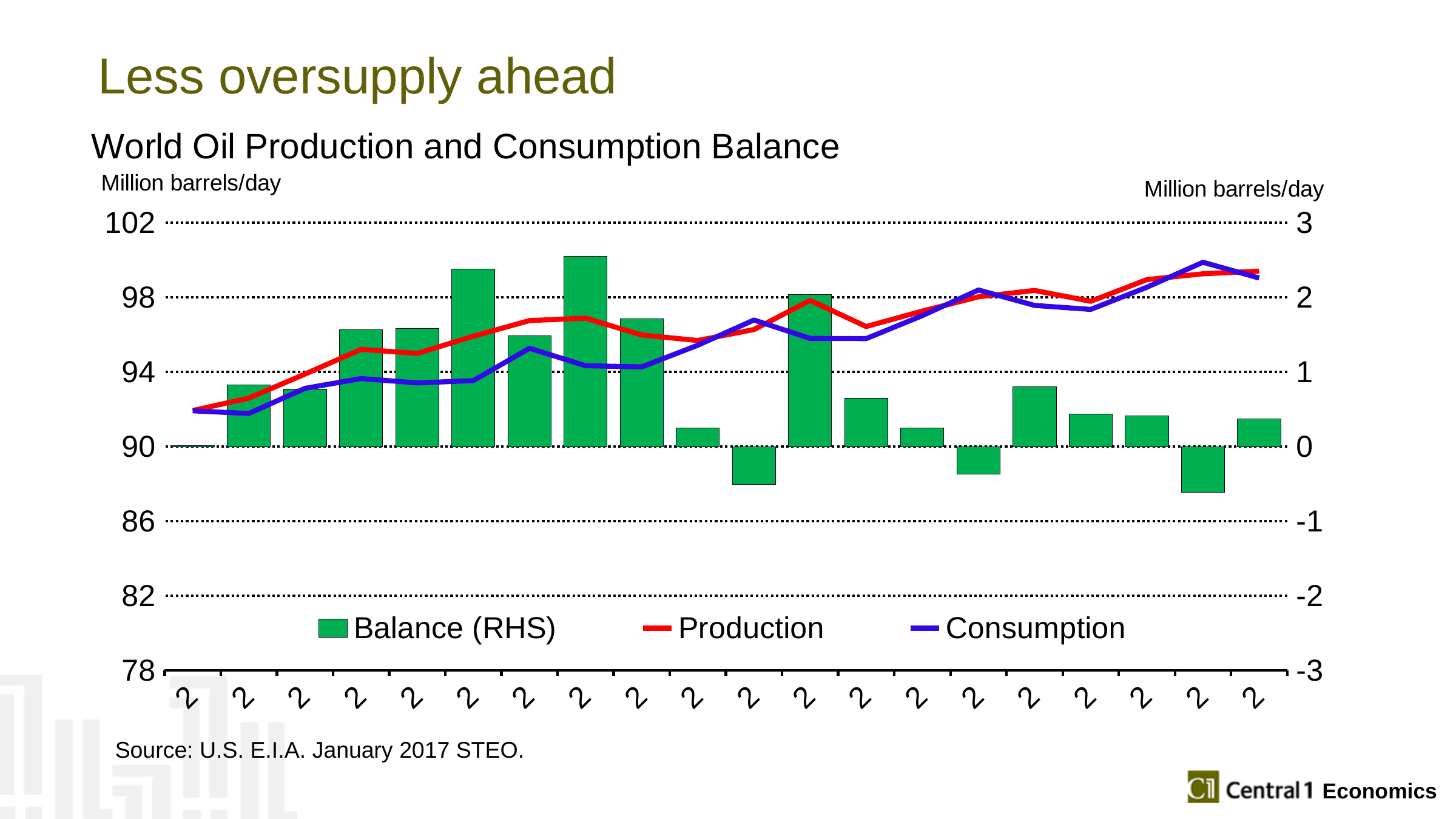
What is the lowest value shown on the right-hand axis? -3 What kind of chart is shown on the slide? A combination bar and line chart Is the lowest Balance bar greater or less than 0 on the right-hand axis? less What is the highest value shown on the left-hand axis? 102 Which series is plotted as bars? Balance (RHS) How many series does the legend list? 3 Is the tallest Balance bar greater or less than 2 on the right-hand axis? greater Does the Production line generally rise or fall from left to right? Rise Does the Consumption line generally rise or fall from left to right? Rise How many Balance bars fall below zero? 3